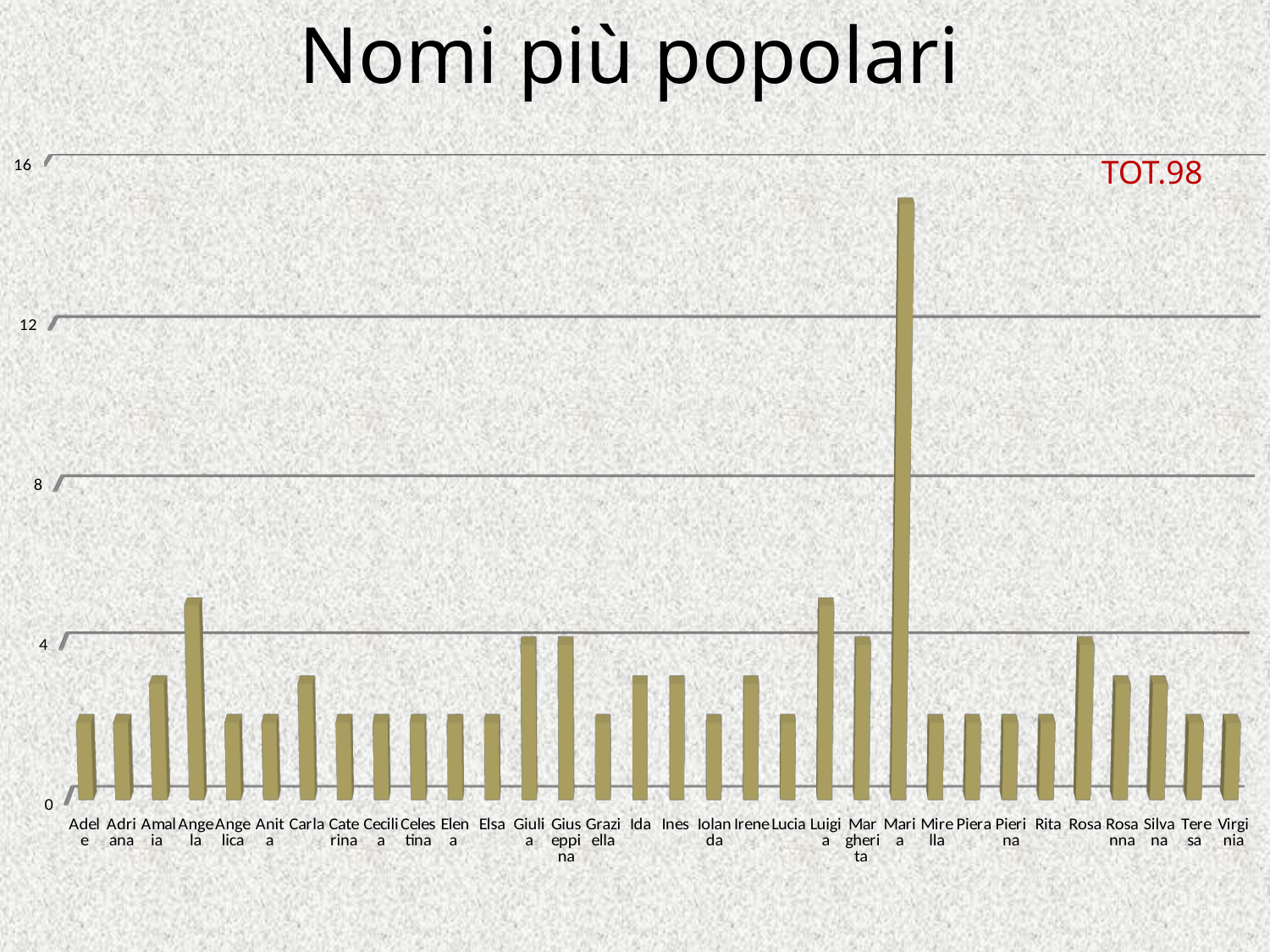
Is the value for Angela greater or less than 4? greater Is the value for Adele greater or less than 4? less What is the title of the chart? Nomi più popolari Is the value for Carla greater or less than 4? less Which is larger, the value for Maria or the value for Angela? Maria How many names are shown on the x axis? 32 What total is written in red on the chart? TOT.98 What type of chart is shown on the slide? bar chart Which is larger, the value for Angela or the value for Adele? Angela Which name has the highest bar? Maria